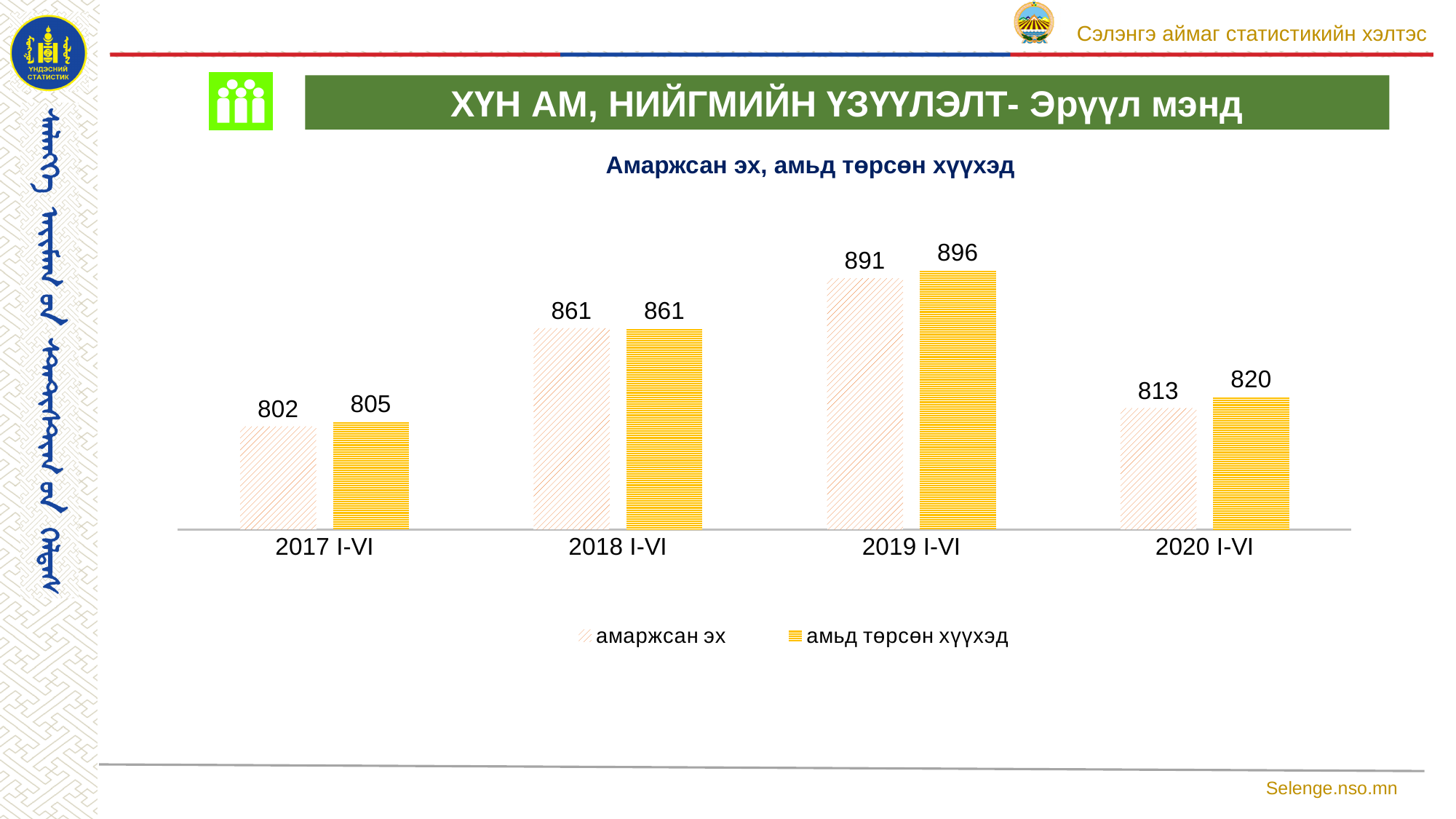
What is the value for амьд төрсөн хүүхэд in 2019 I-VI? 896 How many series does the legend list? 2 What is the difference between амаржсан эх in 2019 I-VI and 2018 I-VI? 30 What is the difference between амьд төрсөн хүүхэд and амаржсан эх in 2020 I-VI? 7 What is the value for амаржсан эх in 2020 I-VI? 813 What kind of chart is shown on the slide? bar chart What is the title of the chart? Амаржсан эх, амьд төрсөн хүүхэд Which is larger: амаржсан эх in 2018 I-VI or амаржсан эх in 2020 I-VI? 2018 I-VI In which period is амьд төрсөн хүүхэд highest? 2019 I-VI How many periods are shown on the x axis? 4 What is the value for амаржсан эх in 2017 I-VI? 802 In which period is амаржсан эх lowest? 2017 I-VI